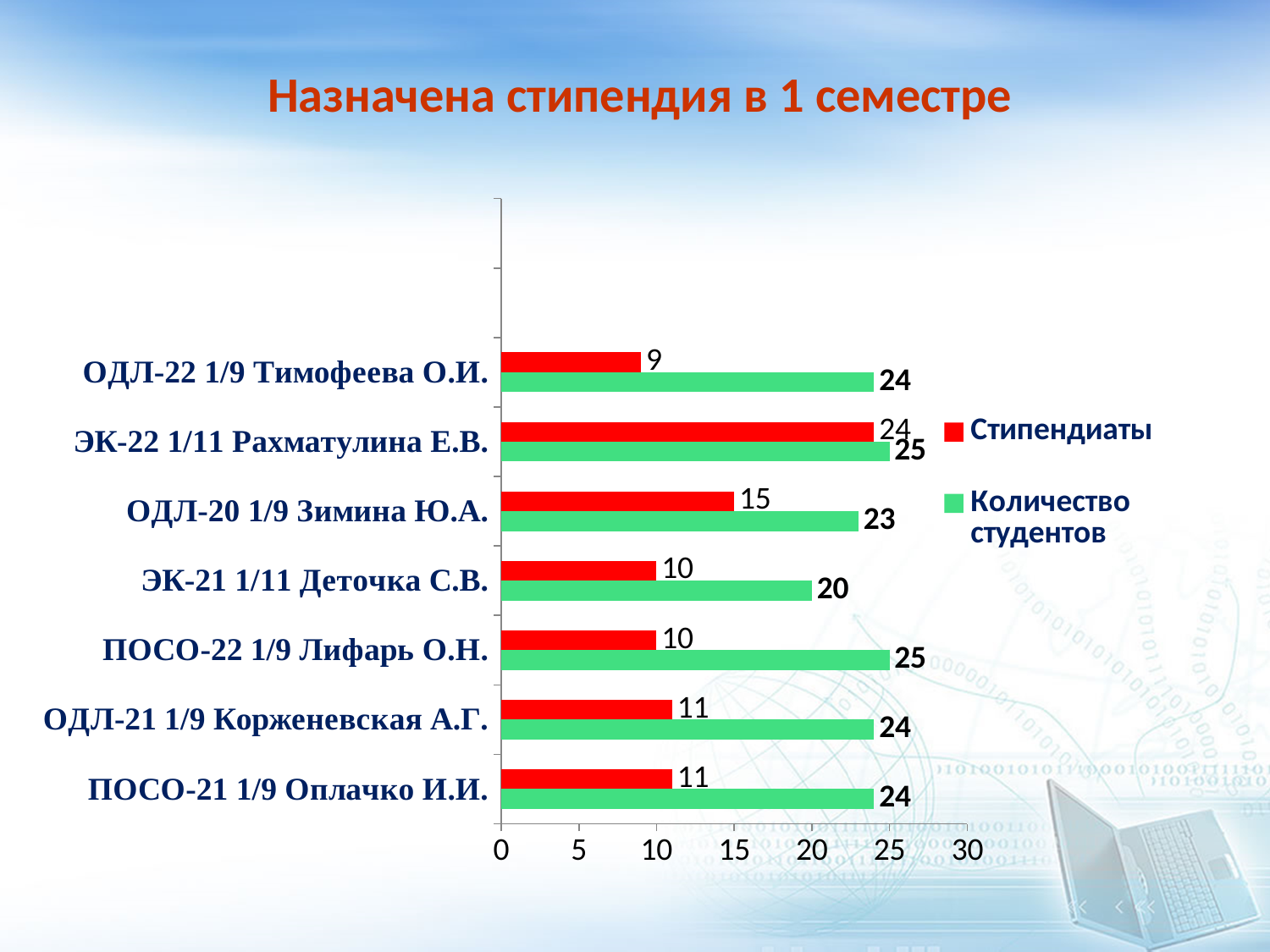
What is the value of Количество студентов for ЭК-21 1/11 Деточка С.В.? 20 What is the title of the chart? Назначена стипендия в 1 семестре Which group has the highest value of Стипендиаты? ЭК-22 1/11 Рахматулина Е.В. How many series does the legend list? 2 Which is larger: Стипендиаты for ОДЛ-20 1/9 Зимина Ю.А. or Стипендиаты for ОДЛ-21 1/9 Корженевская А.Г.? ОДЛ-20 1/9 Зимина Ю.А. What is the value of Стипендиаты for ОДЛ-20 1/9 Зимина Ю.А.? 15 Which group has the lowest value of Стипендиаты? ОДЛ-22 1/9 Тимофеева О.И. Which group has the lowest value of Количество студентов? ЭК-21 1/11 Деточка С.В. What is the difference between Количество студентов and Стипендиаты for ПОСО-22 1/9 Лифарь О.Н.? 15 How many labeled groups are shown on the chart? 7 What kind of chart is shown on the slide? Bar chart What is the value of Стипендиаты for ОДЛ-22 1/9 Тимофеева О.И.? 9